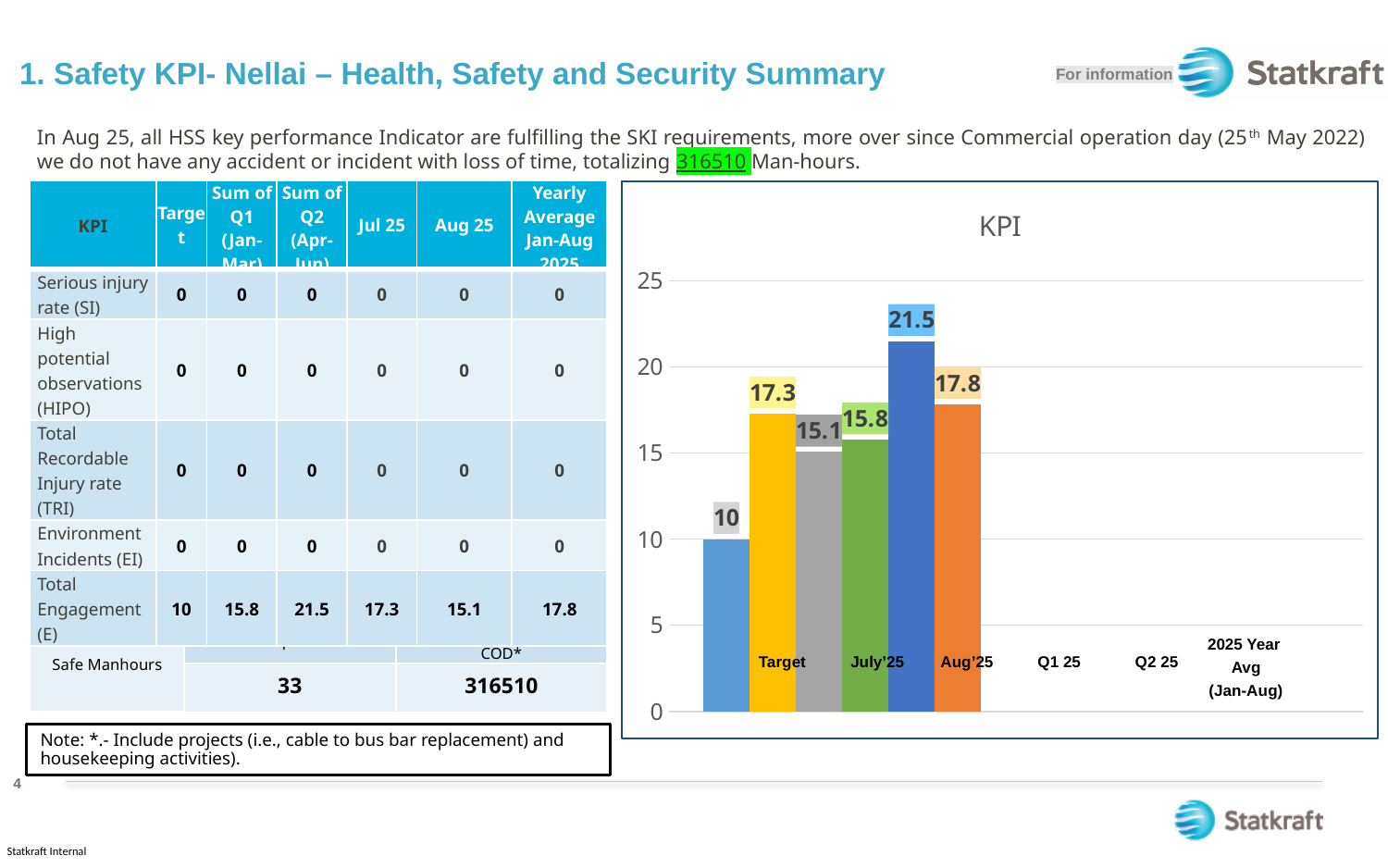
What is the value for July'25 in the KPI chart? 17.3 What type of chart is the KPI chart? bar chart What is the value for Aug'25 in the KPI chart? 15.1 In the KPI chart, which is larger: the value for July'25 or the value for Aug'25? July'25 What is the difference between the Q2 25 value and the Q1 25 value in the KPI chart? 5.7 What is the value of the Target bar in the KPI chart? 10 Which category has the highest value in the KPI chart? Q2 25 How many bars are plotted in the KPI chart? 6 Which category has the lowest value in the KPI chart? Target What is the value for Q2 25 in the KPI chart? 21.5 Is the value for the 2025 Year Avg (Jan-Aug) bar in the KPI chart greater or less than 15? greater What is the title of the chart on the slide? KPI